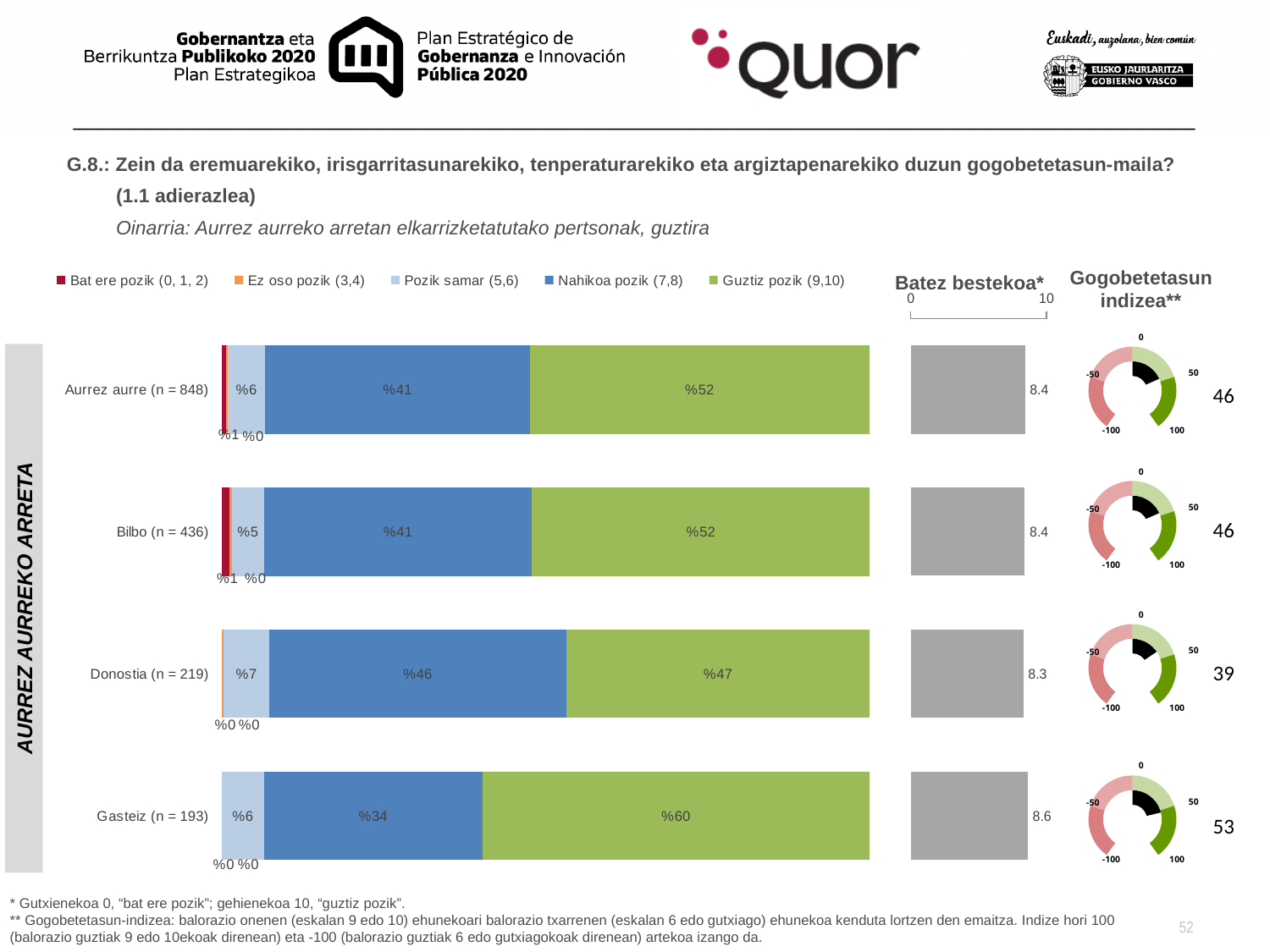
In the stacked bar chart, what percentage of Gasteiz (n = 193) respondents answered 'Guztiz pozik (9,10)'? %60 In the stacked bar chart, what is the difference between the 'Guztiz pozik (9,10)' percentages of Gasteiz (n = 193) and Donostia (n = 219)? 13 percentage points In the 'Batez bestekoa*' chart, what is the average value for Gasteiz (n = 193)? 8.6 In the stacked bar chart, which category has the highest 'Guztiz pozik (9,10)' percentage? Gasteiz (n = 193) How many categories are shown in the stacked bar chart? 4 How many series does the legend of the stacked bar chart list? 5 What kind of chart is the main chart showing the satisfaction percentages? Stacked bar chart In the stacked bar chart, is the 'Nahikoa pozik (7,8)' percentage larger for Donostia (n = 219) or for Bilbo (n = 436)? Donostia (n = 219) In the stacked bar chart, what percentage of Donostia (n = 219) respondents answered 'Nahikoa pozik (7,8)'? %46 In the stacked bar chart, what percentage of Aurrez aurre (n = 848) respondents answered 'Pozik samar (5,6)'? %6 In the stacked bar chart, which category has the lowest 'Nahikoa pozik (7,8)' percentage? Gasteiz (n = 193) In the 'Gogobetetasun indizea**' gauges, which category has the lowest index value? Donostia (n = 219)